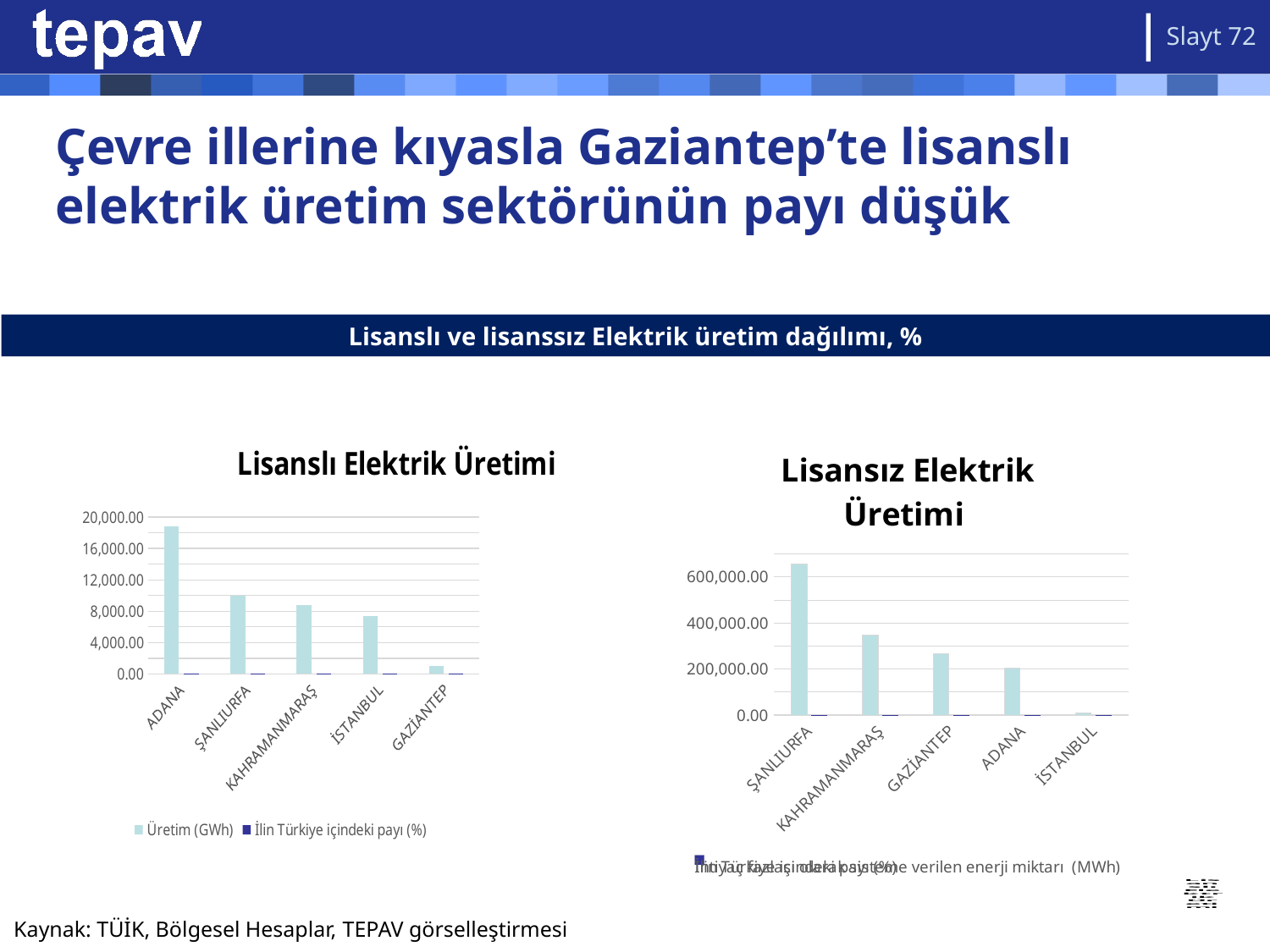
In the 'Lisanslı Elektrik Üretimi' chart, is the Üretim (GWh) value for ADANA greater or less than 16,000.00? greater In the 'Lisanslı Elektrik Üretimi' chart, is the Üretim (GWh) value for GAZİANTEP greater or less than 4,000.00? less In the 'Lisanslı Elektrik Üretimi' chart, do the Üretim (GWh) bars rise or fall from left to right along the x axis? fall In the 'Lisansız Elektrik Üretimi' chart on the right, is the value for ŞANLIURFA greater or less than 600,000.00? greater In the 'Lisanslı Elektrik Üretimi' chart, how many series does the legend list? 2 In the 'Lisanslı Elektrik Üretimi' chart, how many provinces are shown on the x axis? 5 In the 'Lisansız Elektrik Üretimi' chart on the right, which has the larger bar, KAHRAMANMARAŞ or ADANA? KAHRAMANMARAŞ In the 'Lisansız Elektrik Üretimi' chart on the right, which province has the tallest bar? ŞANLIURFA What kind of chart is the 'Lisanslı Elektrik Üretimi' chart on the left? bar chart In the 'Lisanslı Elektrik Üretimi' chart, which province has the highest Üretim (GWh) bar? ADANA In the 'Lisanslı Elektrik Üretimi' chart, which province has the lowest Üretim (GWh) bar? GAZİANTEP In the 'Lisansız Elektrik Üretimi' chart on the right, which province has the shortest bar? İSTANBUL